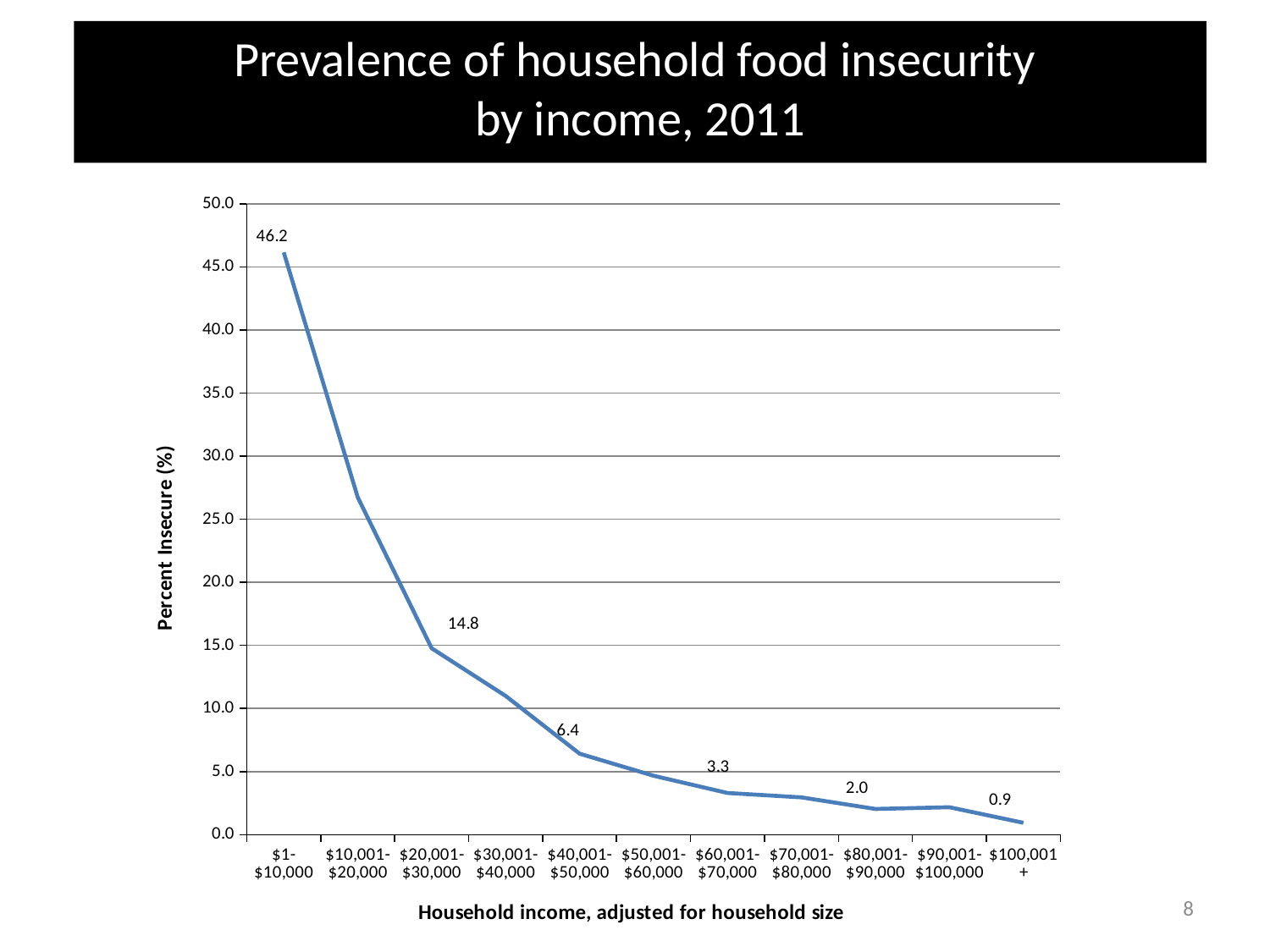
Which has a higher percent insecure: the $60,001-$70,000 group or the $80,001-$90,000 group? $60,001-$70,000 Which income group has the lowest percent insecure? $100,001+ What is the difference in percent insecure between the $1-$10,000 group and the $20,001-$30,000 group? 31.4 Is the percent insecure for the $10,001-$20,000 group greater or less than 20.0? greater Does the percent insecure rise or fall as household income increases along the x axis? fall What type of chart is shown on the slide? line chart What is the percent insecure for the $100,001+ income group? 0.9 What is the percent insecure for households with income of $1-$10,000? 46.2 Which income group has the highest percent insecure? $1-$10,000 What is the percent insecure for the $20,001-$30,000 income group? 14.8 How many income groups are plotted on the x axis? 11 What is the percent insecure for the $40,001-$50,000 income group? 6.4